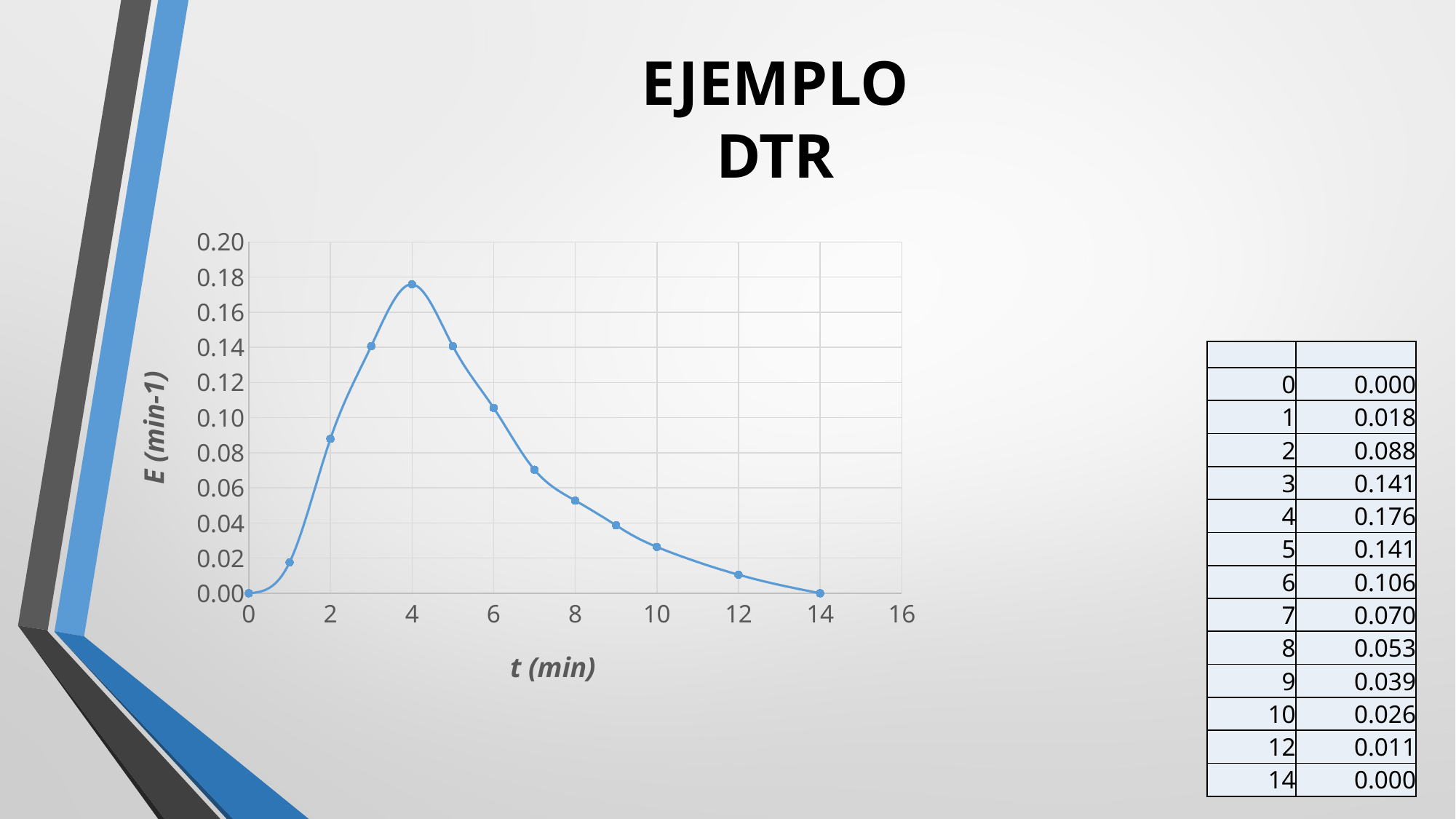
What is the label of the horizontal axis of the chart? t (min) Do the values of E rise or fall as t increases from 4 min to 14 min? fall What is the value of E at t = 10 min? 0.026 Is the value of E at t = 3 min greater or less than 0.12? greater How many data points are plotted on the chart? 13 What kind of chart is shown on the slide? line chart What is the difference between the value of E at t = 4 min and at t = 6 min? 0.070 What is the value of E at t = 7 min? 0.070 What is the label of the vertical axis of the chart? E (min-1) At which value of t (min) does E reach its highest value? 4 What is the value of E at t = 4 min? 0.176 Which is larger, the value of E at t = 2 min or at t = 8 min? t = 2 min